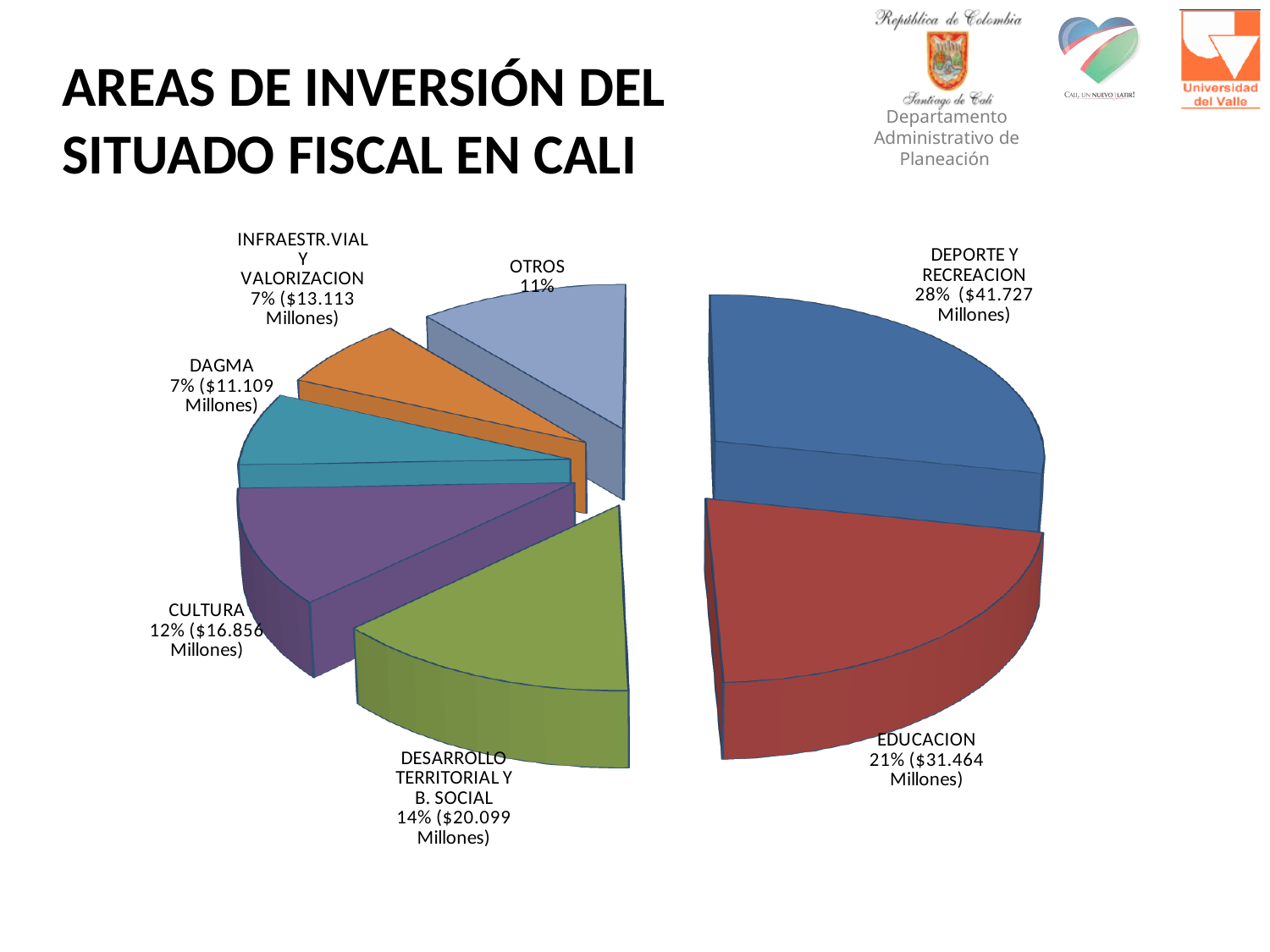
What is the difference in percentage points between DEPORTE Y RECREACION and EDUCACION? 7 Which category has the largest share of the pie? DEPORTE Y RECREACION What percentage is shown for CULTURA? 12% What is the value in millions for INFRAESTR.VIAL Y VALORIZACION? $13.113 Millones What is the title of the slide containing the chart? AREAS DE INVERSIÓN DEL SITUADO FISCAL EN CALI What kind of chart is shown on the slide? pie chart How many slices does the pie chart have? 7 What is the value in millions for DESARROLLO TERRITORIAL Y B. SOCIAL? $20.099 Millones Which has a larger share, CULTURA or DAGMA? CULTURA What is the value in millions for EDUCACION? $31.464 Millones What percentage is shown for OTROS? 11% What share of the pie does DEPORTE Y RECREACION represent? 28%